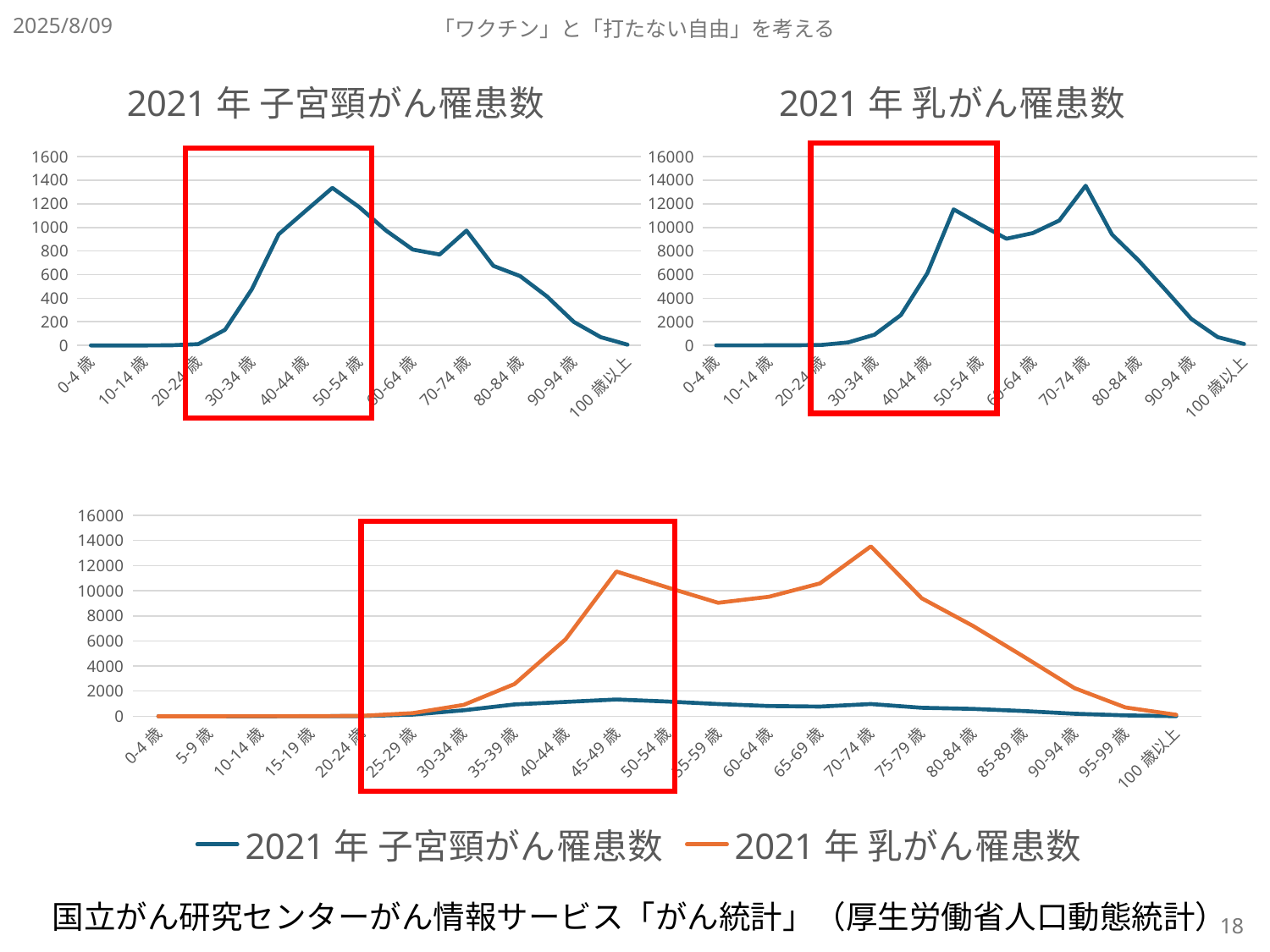
In the top-right chart titled 2021 年 乳がん罹患数, is the value for 30-34 歳 greater or less than 2000? less In the top-left chart titled 2021 年 子宮頸がん罹患数, is the value for 40-44 歳 greater or less than 800? greater In the bottom chart, which age group has the highest value for 2021 年 子宮頸がん罹患数? 45-49 歳 In the top-left chart titled 2021 年 子宮頸がん罹患数, is the value for 0-4 歳 greater or less than 200? less How many age-group categories are shown on the x axis of the bottom chart? 21 What kind of chart is the top-left chart titled 2021 年 子宮頸がん罹患数? line chart In the bottom chart, which series is larger at 70-74 歳? 2021 年 乳がん罹患数 In the bottom chart, which series is larger at 45-49 歳? 2021 年 乳がん罹患数 In the top-left chart titled 2021 年 子宮頸がん罹患数, do the values rise or fall from 70-74 歳 to 100 歳以上? fall How many series does the legend of the bottom chart list? 2 In the top-right chart titled 2021 年 乳がん罹患数, which age group has the highest value? 70-74 歳